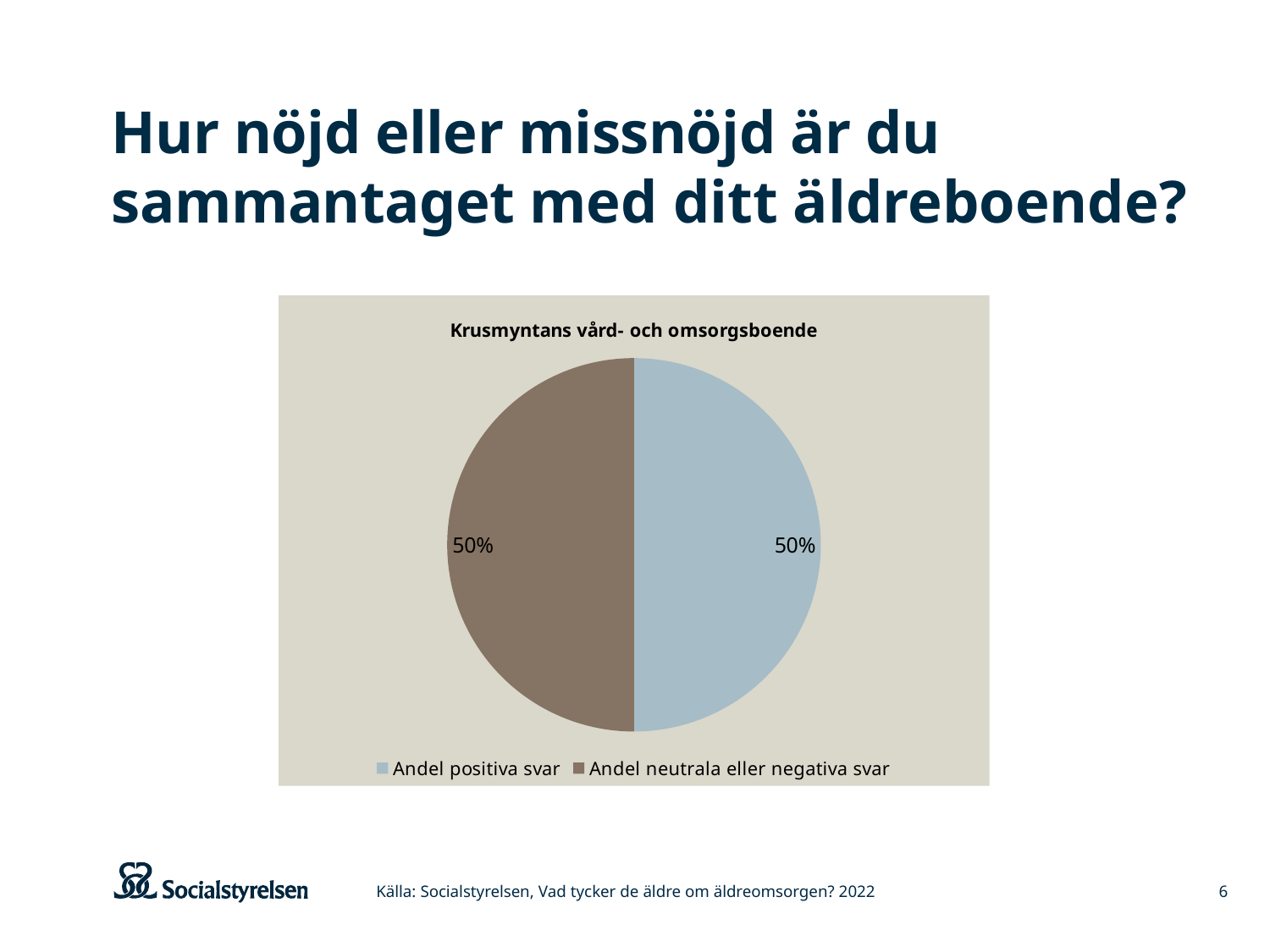
Is the value for "Andel positiva svar" greater or less than 60%? less What kind of chart is shown on the slide? Pie chart What do the two slices of the pie add up to? 100% What is the difference between the "Andel positiva svar" slice and the "Andel neutrala eller negativa svar" slice? 0% What is the value shown for the "Andel neutrala eller negativa svar" slice? 50% What share of the pie does "Andel neutrala eller negativa svar" represent? 50% What is the title of the chart? Krusmyntans vård- och omsorgsboende Which legend entry is shown in brown? Andel neutrala eller negativa svar What is the value shown for the "Andel positiva svar" slice? 50% What share of the pie does "Andel positiva svar" represent? 50% How many slices does the pie chart have? 2 How many entries does the legend list? 2